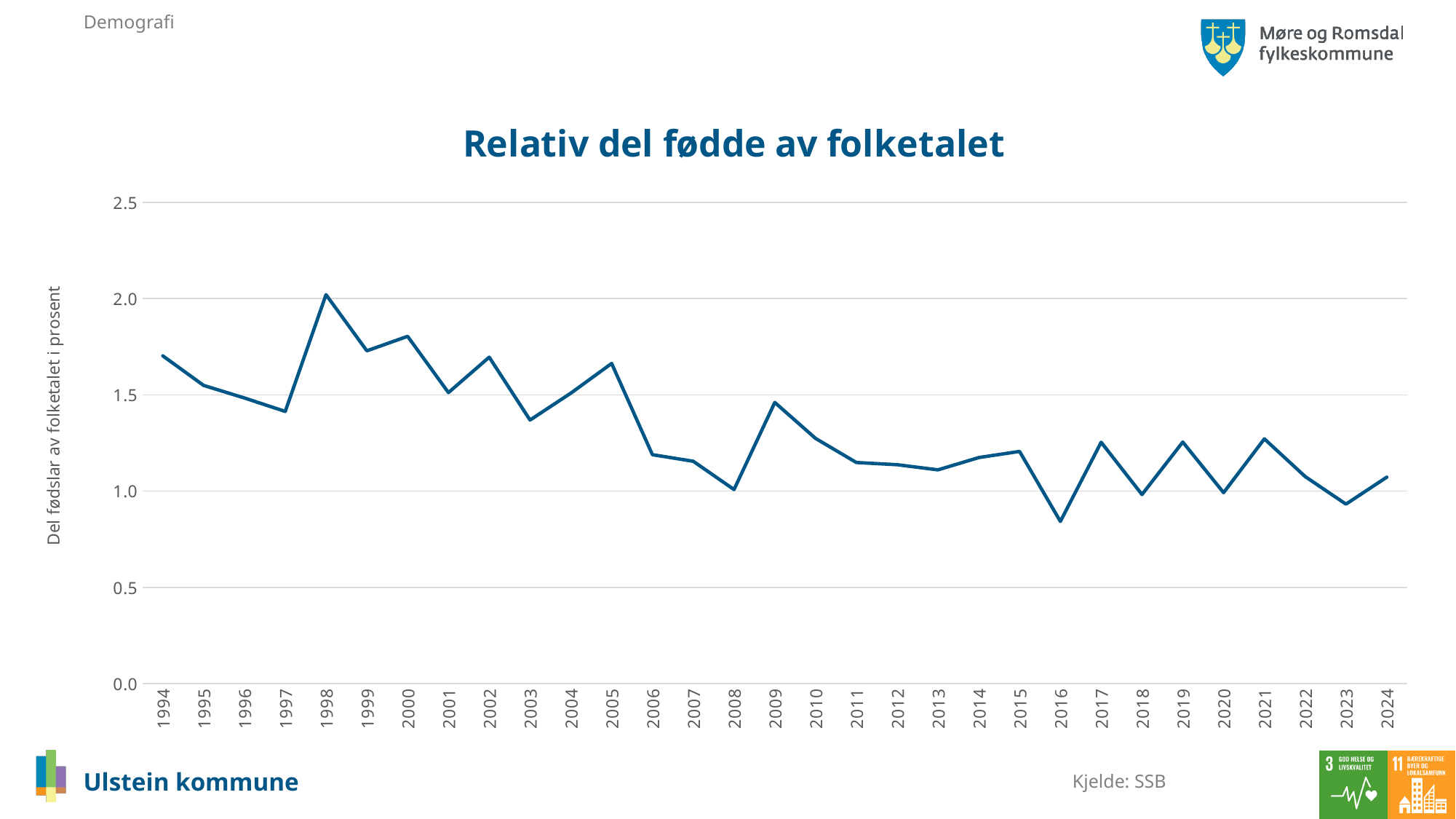
What is the label of the vertical axis? Del fødslar av folketalet i prosent How many years are plotted along the x axis? 31 What is the title of the chart? Relativ del fødde av folketalet Is the value for 2016 greater or less than 1.0? less Is the value for 1994 greater or less than 1.5? greater Which year has the highest value? 1998 Which year has the lowest value? 2016 Which is larger, the value for 2000 or the value for 2010? 2000 Is the value for 2008 greater or less than 1.5? less Overall, do the values rise or fall from 1994 to 2024? fall What kind of chart is shown on the slide? line chart